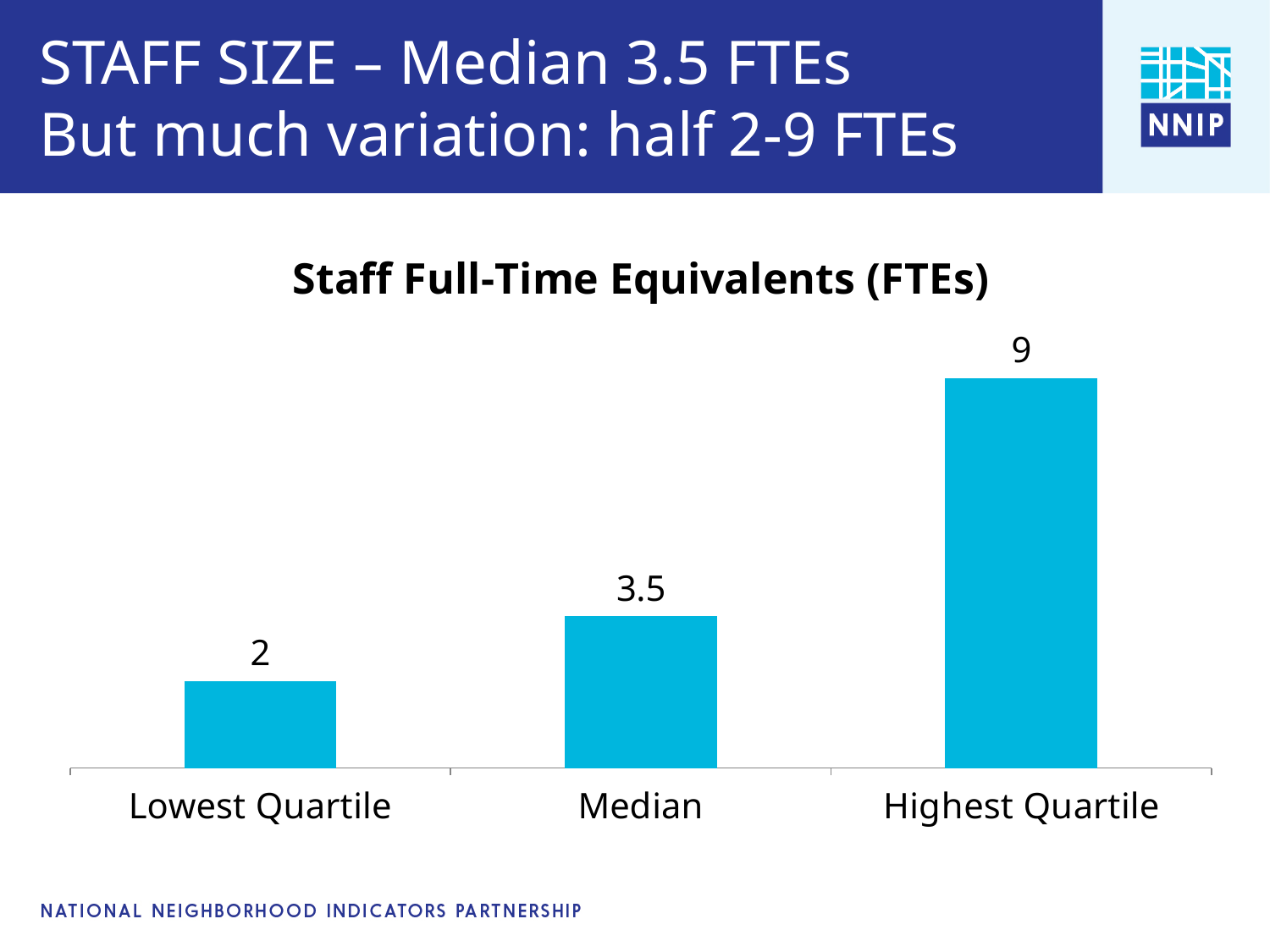
What is the difference between the Highest Quartile and the Lowest Quartile values? 7 What is the value for Highest Quartile? 9 What is the value for Median? 3.5 What is the value for Lowest Quartile? 2 What is the difference between the Median and the Lowest Quartile values? 1.5 Which category has the highest value? Highest Quartile Do the values rise or fall from left to right across the categories? Rise How many categories are shown in the chart? 3 Which is larger, the value for Median or the value for Highest Quartile? Highest Quartile What is the title of the chart? Staff Full-Time Equivalents (FTEs) What kind of chart is shown on the slide? Bar chart Which category has the lowest value? Lowest Quartile